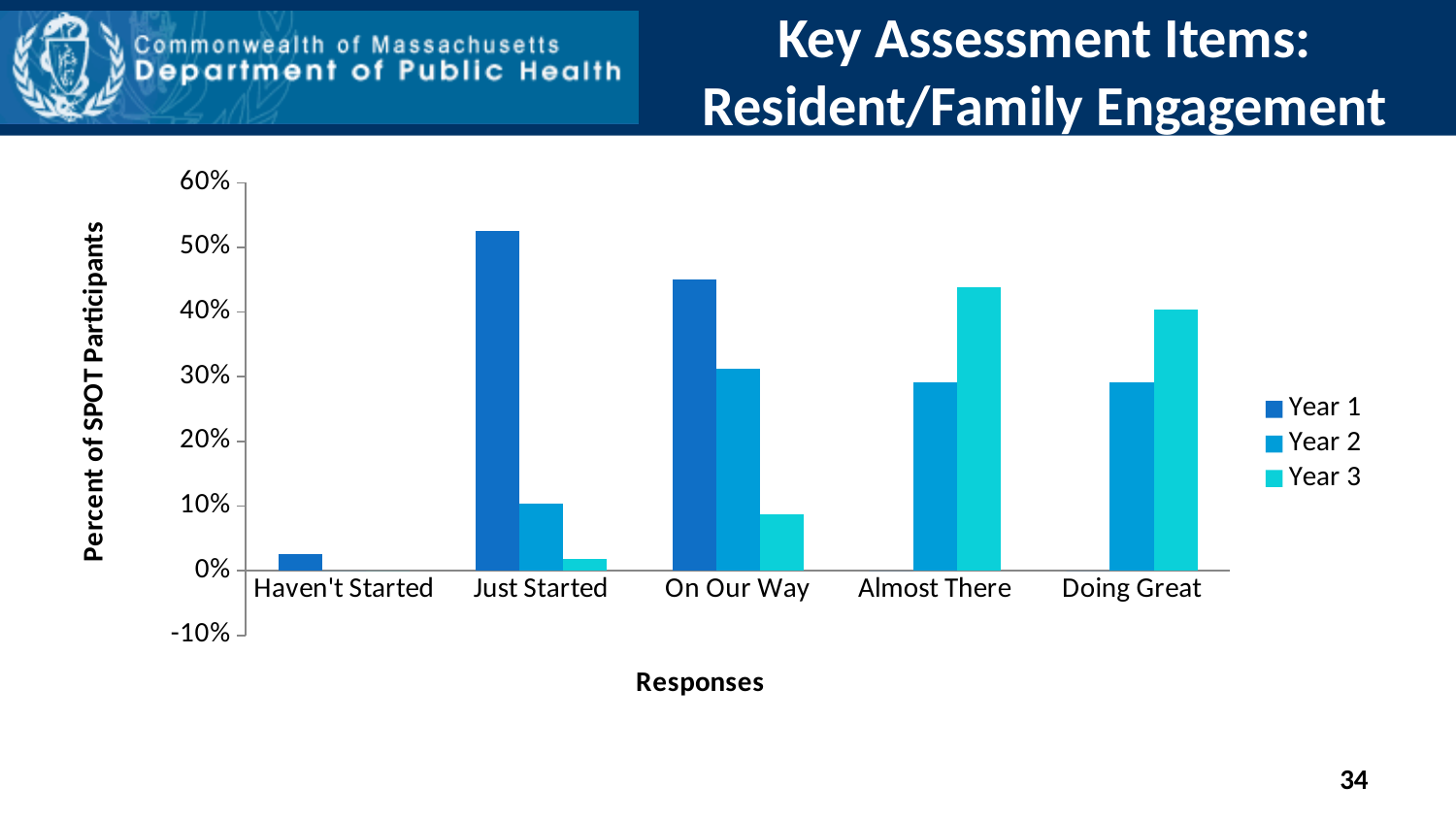
Is the Year 3 value for Almost There greater or less than 40%? greater Which response category has the highest Year 3 value? Almost There How many response categories are shown on the x axis? 5 What kind of chart is shown on the slide? bar chart Is the Year 1 value for Just Started greater or less than 50%? greater Do the Year 3 values rise or fall from Just Started to Almost There? rise Which response category has the highest Year 1 value? Just Started For On Our Way, which is larger: the Year 1 value or the Year 2 value? Year 1 How many series does the legend list? 3 For Doing Great, which is larger: the Year 2 value or the Year 3 value? Year 3 Is the Year 2 value for On Our Way greater or less than 40%? less What is the title of the vertical axis? Percent of SPOT Participants